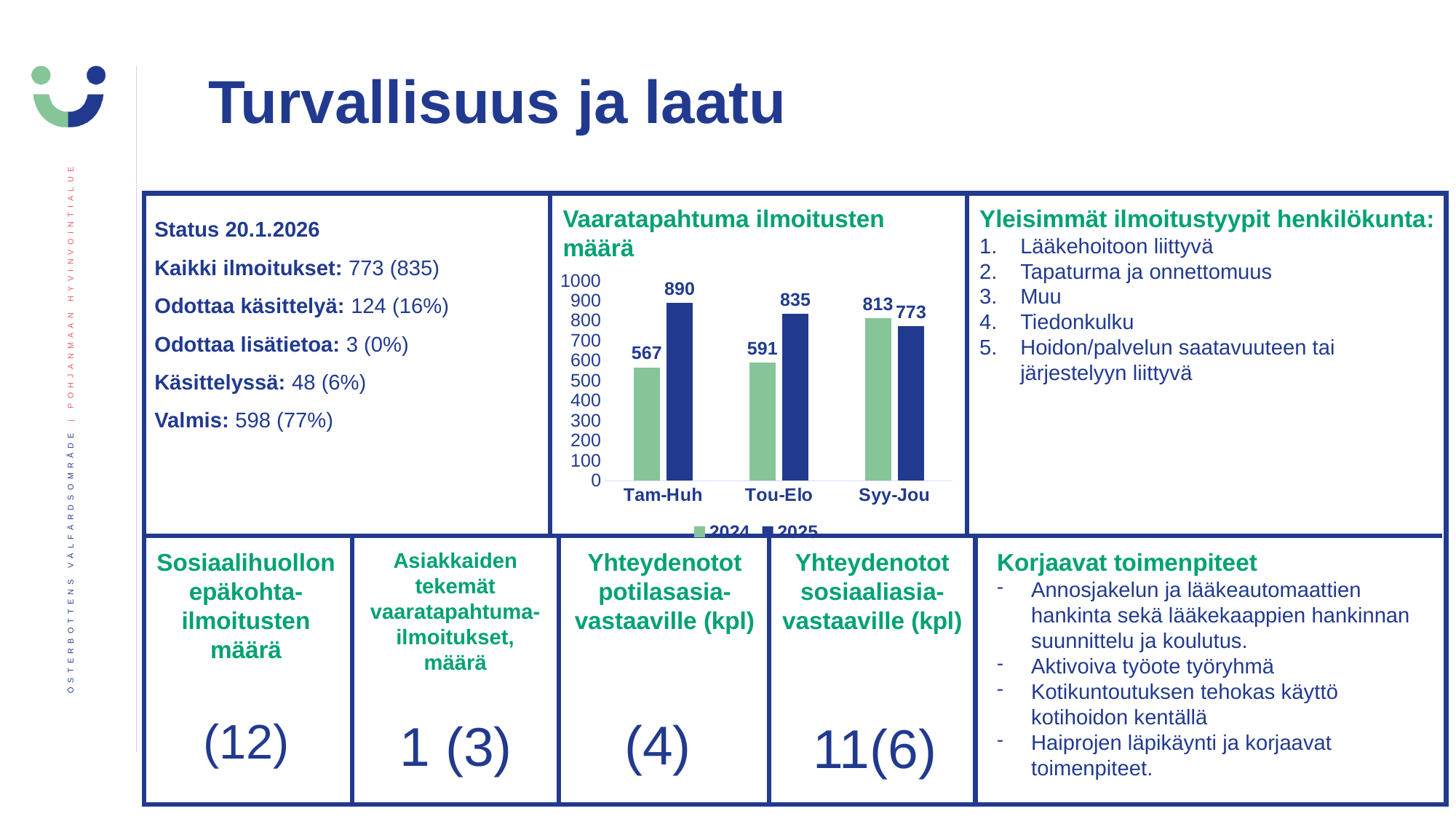
What is the difference between the 2025 and 2024 values in Tam-Huh? 323 Which period has the highest value for the 2025 series? Tam-Huh Which period has the lowest value for the 2024 series? Tam-Huh What is the difference between the 2024 and 2025 values in Syy-Jou? 40 How many series does the chart's legend list? 2 What is the value for 2024 in Tou-Elo? 591 How many periods are shown on the x axis of the chart? 3 In Tou-Elo, which series has the larger value, 2024 or 2025? 2025 What is the value for 2025 in Tam-Huh? 890 What is the value for 2024 in Syy-Jou? 813 Do the values for the 2025 series rise or fall from Tam-Huh to Syy-Jou? fall What kind of chart is shown on the slide? bar chart